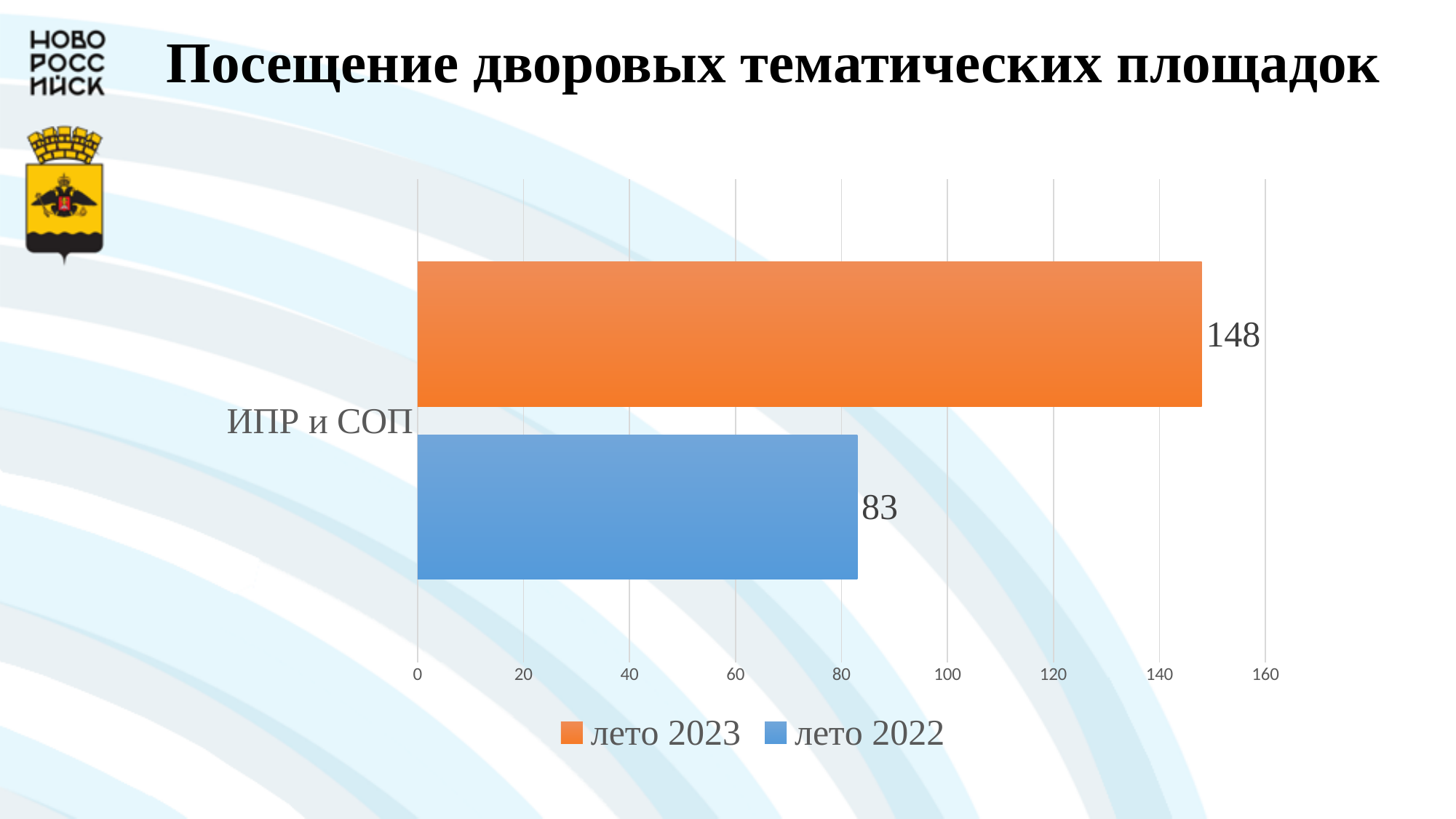
Which colour represents лето 2022 in the legend? blue Which series has the higher value for ИПР и СОП, лето 2023 or лето 2022? лето 2023 How many series does the legend list? 2 How many categories are shown on the chart? 1 Is the value for лето 2022 greater or less than 100? less What is the value for лето 2023 for ИПР и СОП? 148 What is the difference between the лето 2023 and лето 2022 values for ИПР и СОП? 65 What is the title of the slide? Посещение дворовых тематических площадок What is the value for лето 2022 for ИПР и СОП? 83 What kind of chart is shown on the slide? bar chart Is the value for лето 2023 greater or less than 140? greater What is the maximum value shown on the horizontal axis? 160